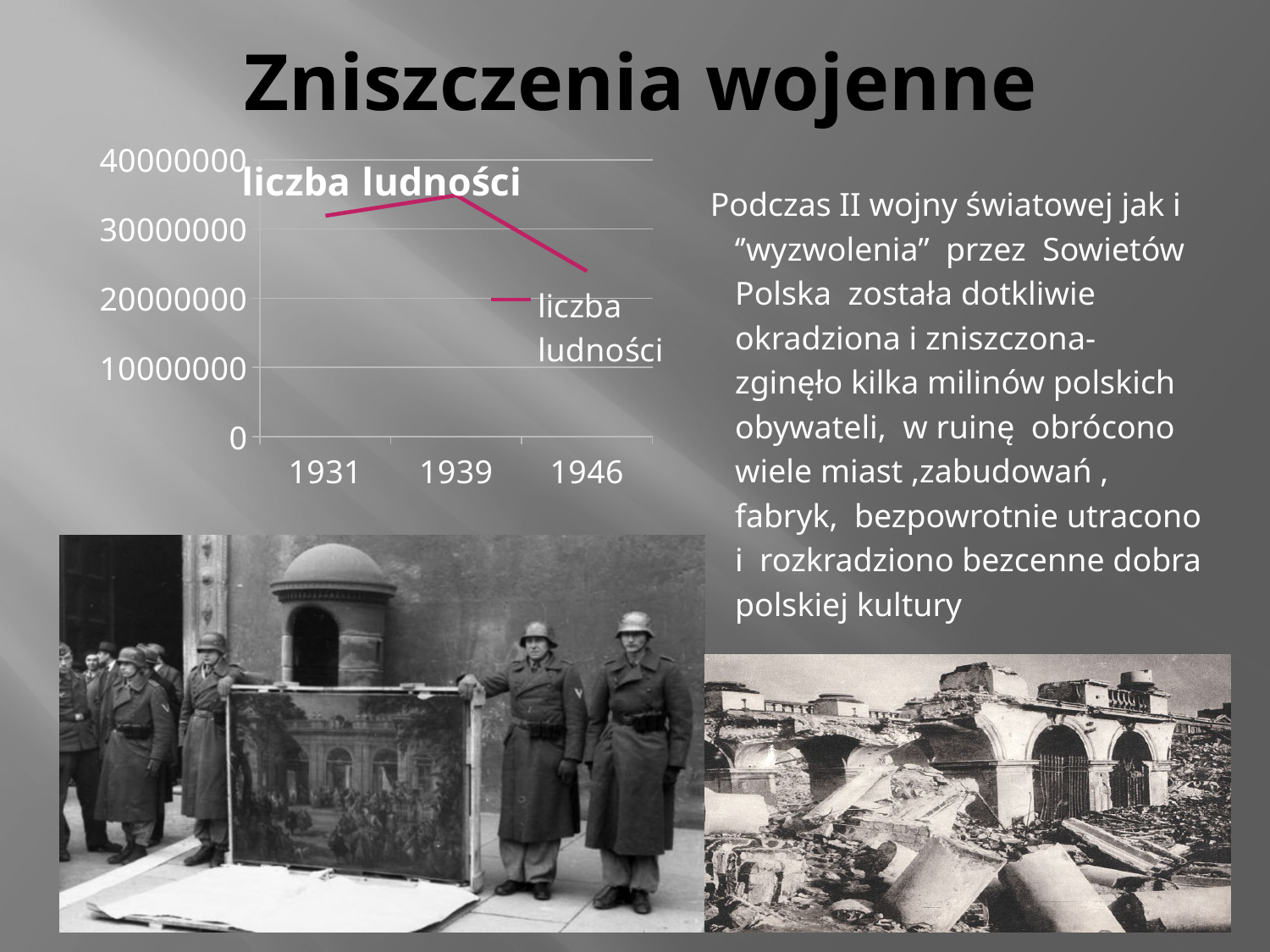
How many years are plotted on the x axis of the chart? 3 What kind of chart is shown on the slide? line chart Is the value for 1931 greater or less than 30000000? greater Which is larger, the value for 1939 or the value for 1946? 1939 What is the title of the chart? liczba ludności Which year has the lowest value for liczba ludności? 1946 Is the value for 1946 greater or less than 30000000? less What is the name of the series shown in the chart's legend? liczba ludności How many series does the chart's legend list? 1 Does the value rise or fall between 1939 and 1946? fall Is the value for 1946 greater or less than 20000000? greater Which year has the highest value for liczba ludności? 1939